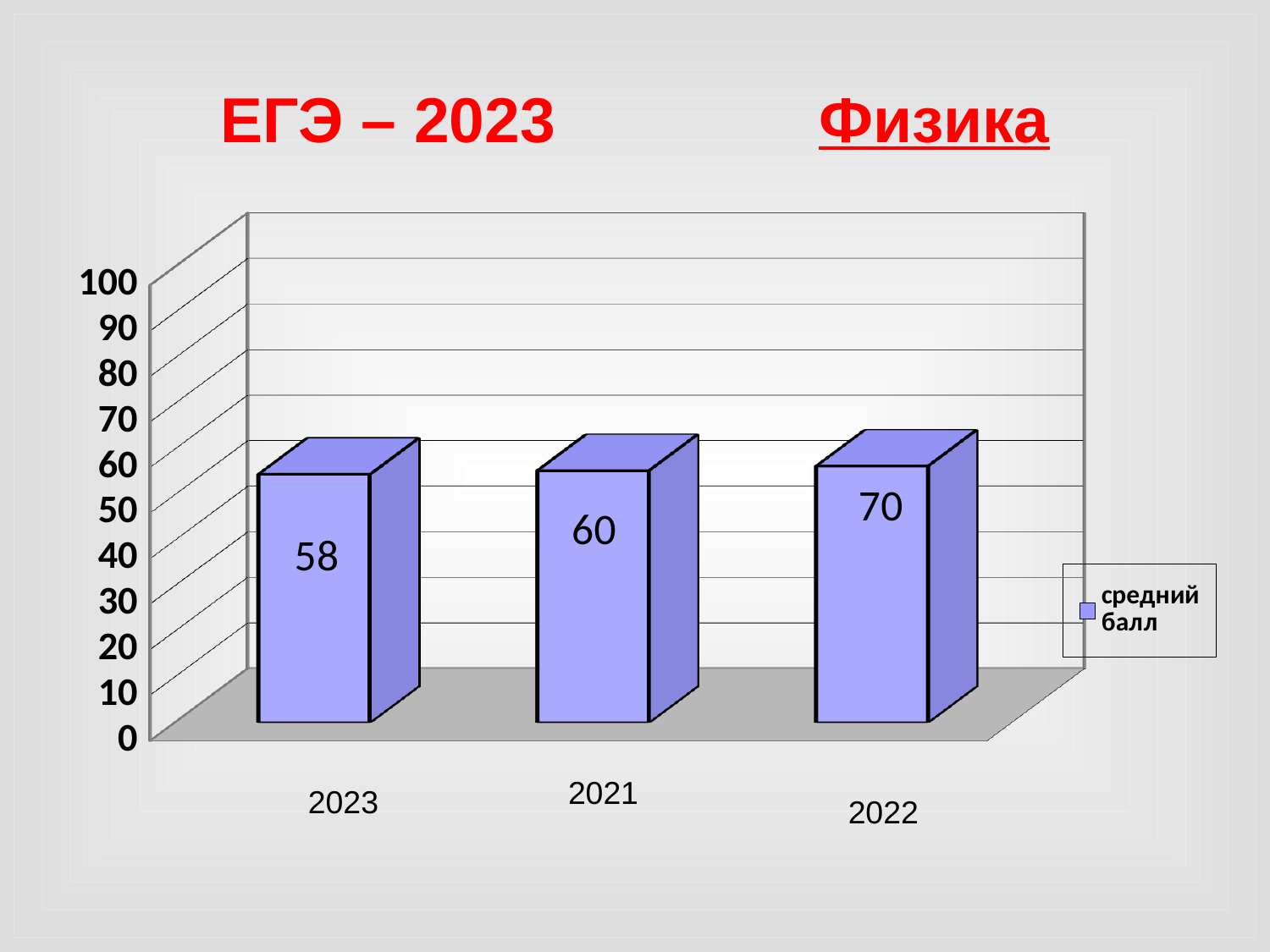
What is the legend entry for the series on the chart? средний балл What is the average score (средний балл) shown for 2023? 58 Which year has the highest average score? 2022 What is the difference between the average score for 2021 and the average score for 2023? 2 What is the average score shown for 2022? 70 What kind of chart is shown on the slide? Bar chart Which year has the lowest average score? 2023 What is the difference between the average score for 2022 and the average score for 2023? 12 How many series does the legend list? 1 How many years (categories) are shown on the chart? 3 Which is larger, the average score for 2021 or for 2022? 2022 What is the average score shown for 2021? 60